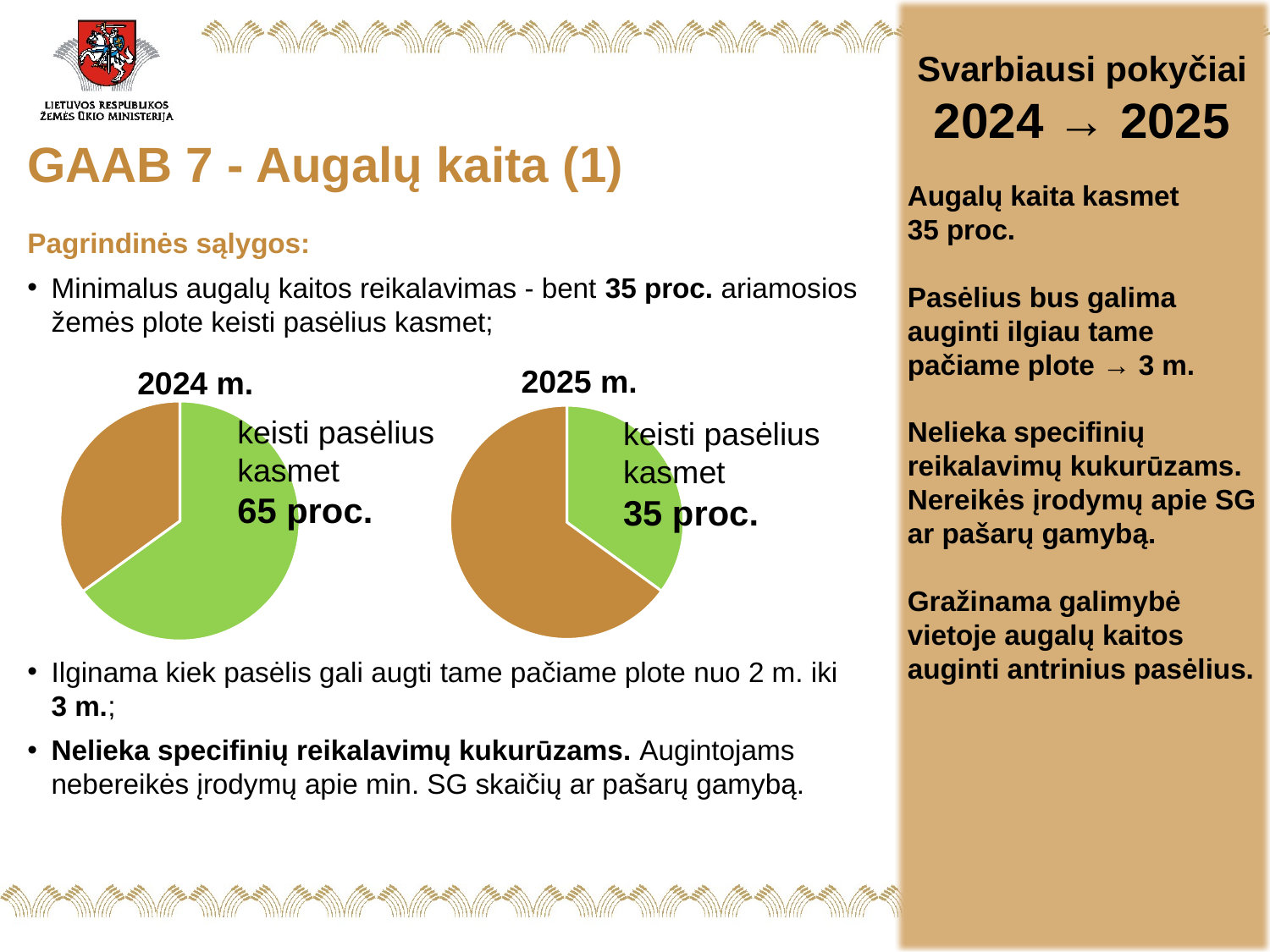
How many slices does the 2024 m. pie chart have? 2 What is the difference between the "keisti pasėlius kasmet" share in the 2024 m. chart and in the 2025 m. chart? 30 proc. How many slices does the 2025 m. pie chart have? 2 In the 2025 m. pie chart, what share is labelled for "keisti pasėlius kasmet"? 35 proc. Is the "keisti pasėlius kasmet" share in the 2025 m. pie chart greater or less than 50 proc.? less In the 2024 m. pie chart, which slice is larger, the green one or the brown one? the green one How many pie charts are shown on the slide? 2 Which chart shows the larger share for "keisti pasėlius kasmet", the 2024 m. chart or the 2025 m. chart? 2024 m. What kind of chart is used for the 2024 m. chart? pie chart In the 2024 m. pie chart, what share is labelled for "keisti pasėlius kasmet"? 65 proc. In the 2025 m. pie chart, which slice is larger, the green one or the brown one? the brown one In the 2024 m. pie chart, what colour is the slice labelled "keisti pasėlius kasmet 65 proc."? green